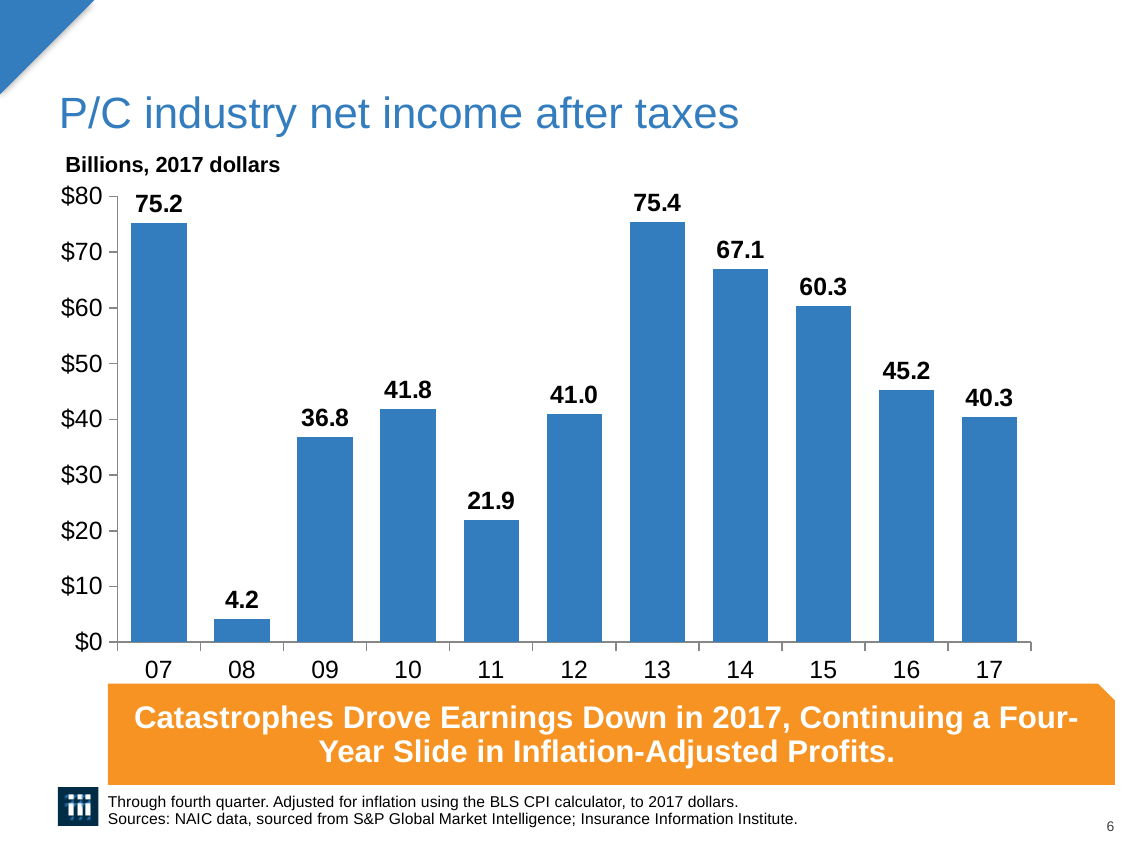
How many years are shown on the x axis? 11 Which year has the lowest net income after taxes? 08 What kind of chart is shown on the slide? Bar chart Is the value for 2015 greater or less than $50? greater Which year has the highest net income after taxes? 13 What is the P/C industry net income after taxes for 2011? 21.9 Which year has the larger value, 2010 or 2012? 10 What is the difference between the values for 2013 and 2014? 8.3 Do the values rise or fall from 2014 to 2017? Fall What is the value shown for 2014? 67.1 What is the difference between the values for 2016 and 2017? 4.9 What is the value shown for 2017? 40.3